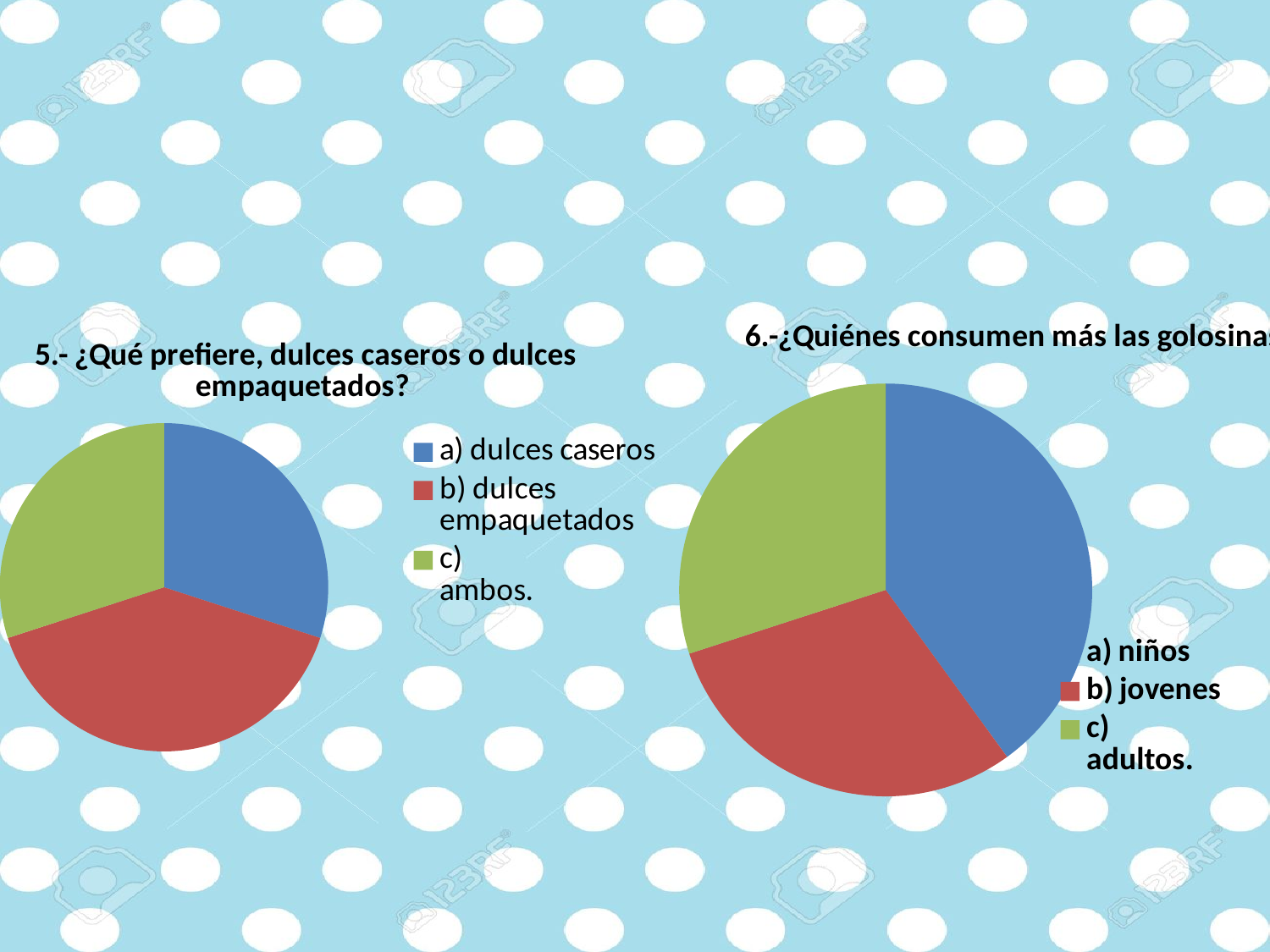
In the right pie chart (question 6), which is larger: the slice for a) niños or the slice for c) adultos? a) niños How many slices does the left pie chart (question 5) have? 3 In the right pie chart (question 6), which category is shown in green? c) adultos. What kind of chart is the right chart titled "6.-¿Quiénes consumen más las golosinas?"? Pie chart How many entries does the legend of the right pie chart (question 6) list? 3 In the right pie chart (question 6), which is larger: the slice for a) niños or the slice for b) jovenes? a) niños In the right pie chart (question 6), which category has the largest slice? a) niños In the left pie chart (question 5), which colour represents b) dulces empaquetados? Red What kind of chart is the left chart titled "5.- ¿Qué prefiere, dulces caseros o dulces empaquetados?"? Pie chart How many slices does the right pie chart (question 6) have? 3 How many entries does the legend of the left pie chart (question 5) list? 3